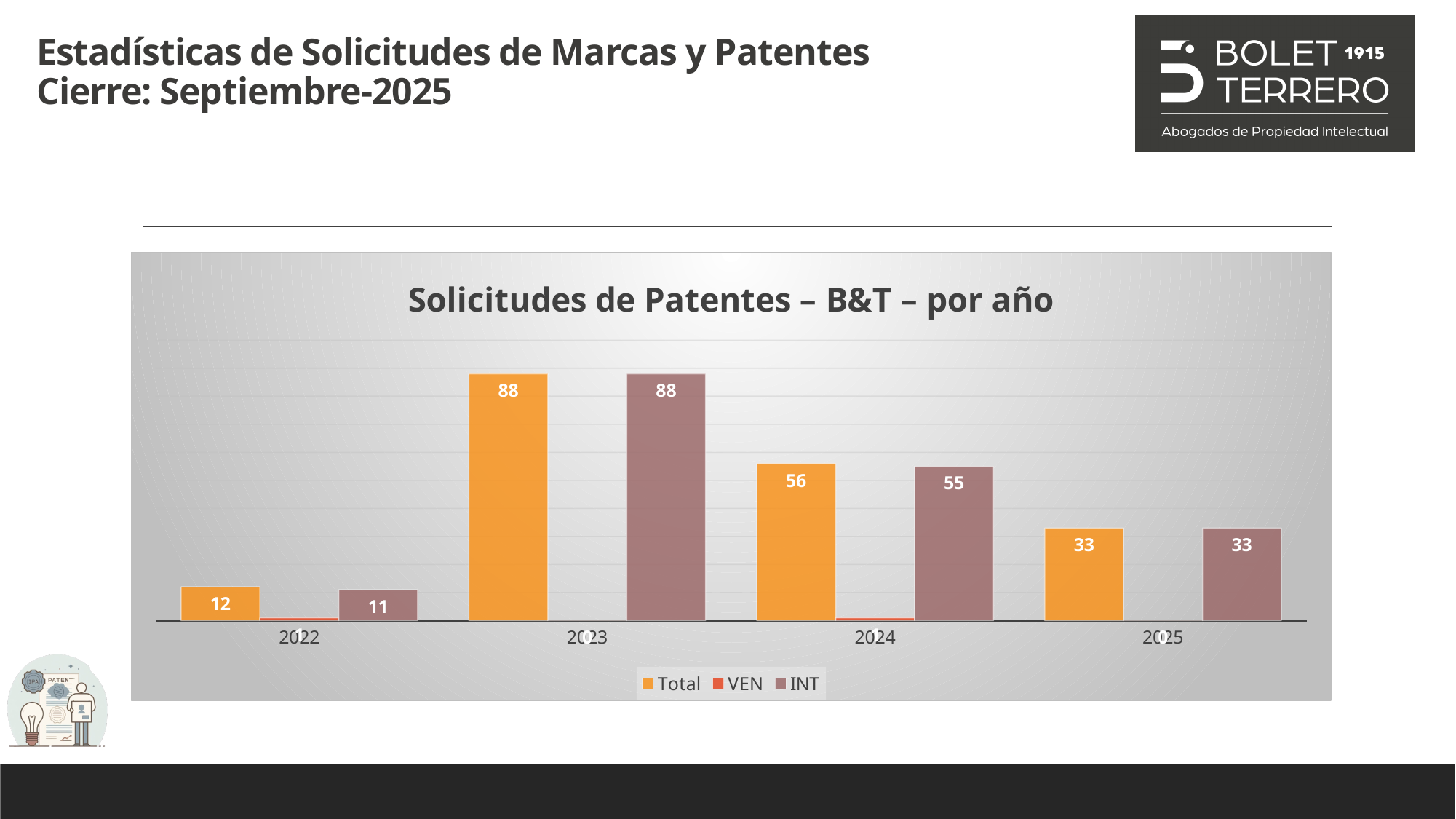
Which year has the lowest INT value? 2022 What is the difference between the Total values for 2023 and 2024? 32 How many years are shown on the x axis? 4 What is the Total value for 2022? 12 What kind of chart is shown on the slide? Bar chart How many series does the legend list? 3 What is the difference between the INT values for 2023 and 2025? 55 What is the Total value for 2023? 88 Do the Total values rise or fall from 2023 to 2025? Fall Which year has the highest Total value? 2023 What is the INT value for 2024? 55 Which is larger in 2022, the Total value or the INT value? Total